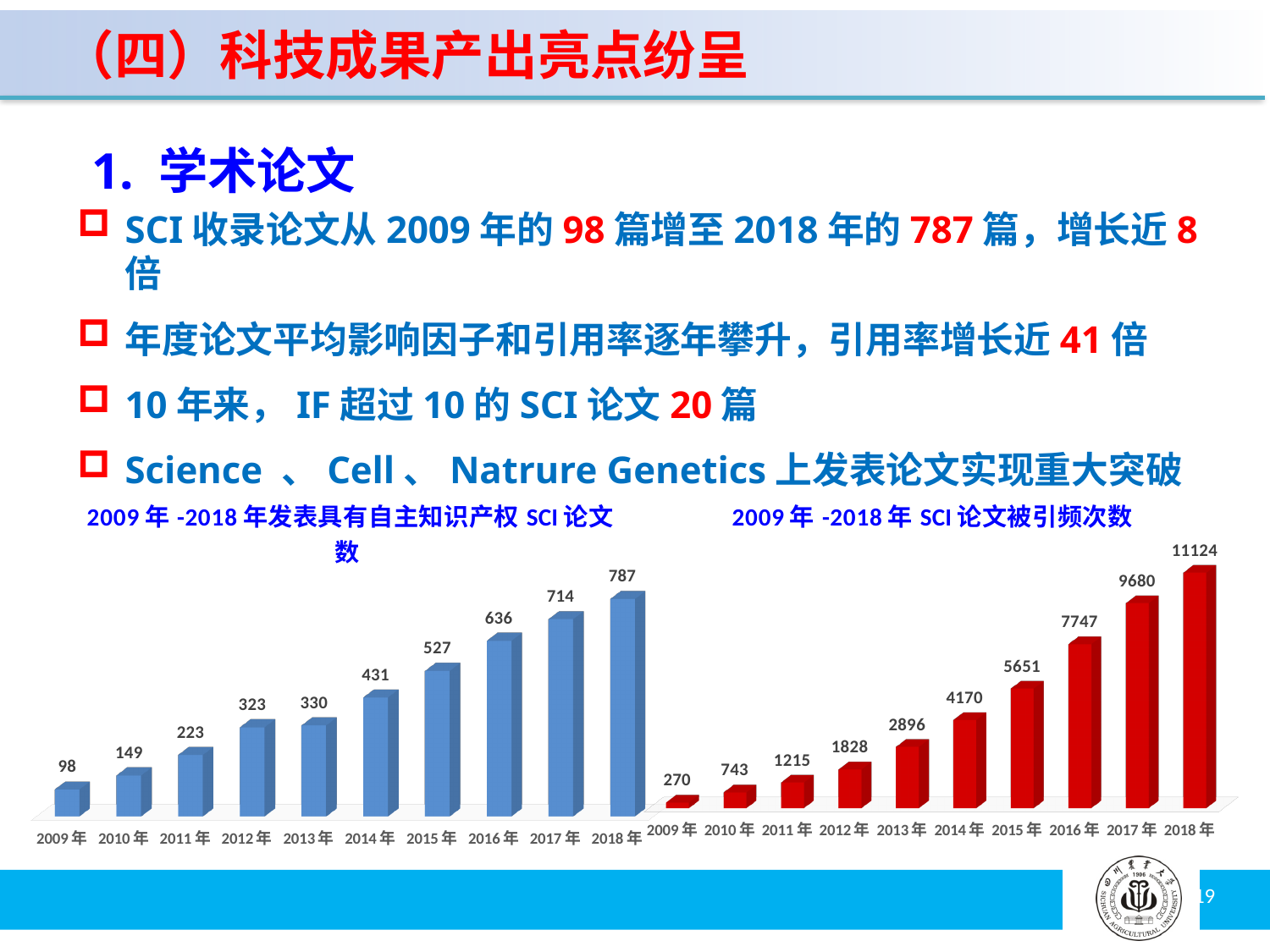
In the left chart, which is larger, the value for 2012年 or the value for 2013年? 2013年 How many years (bars) are shown in the right chart? 10 What kind of chart is the left chart? bar chart In the right chart, what is the difference between the values for 2018年 and 2017年? 1444 What colour are the bars in the right chart? red In the left chart (2009年-2018年发表具有自主知识产权SCI论文数), what is the value for 2014年? 431 In the left chart, what is the value for 2016年? 636 In the left chart, what is the difference between the values for 2018年 and 2009年? 689 In the left chart, which year has the highest value? 2018年 In the right chart, which year has the lowest value? 2009年 In the right chart (2009年-2018年SCI论文被引频次数), what is the value for 2013年? 2896 In the right chart, do the values rise or fall from 2009年 to 2018年? rise